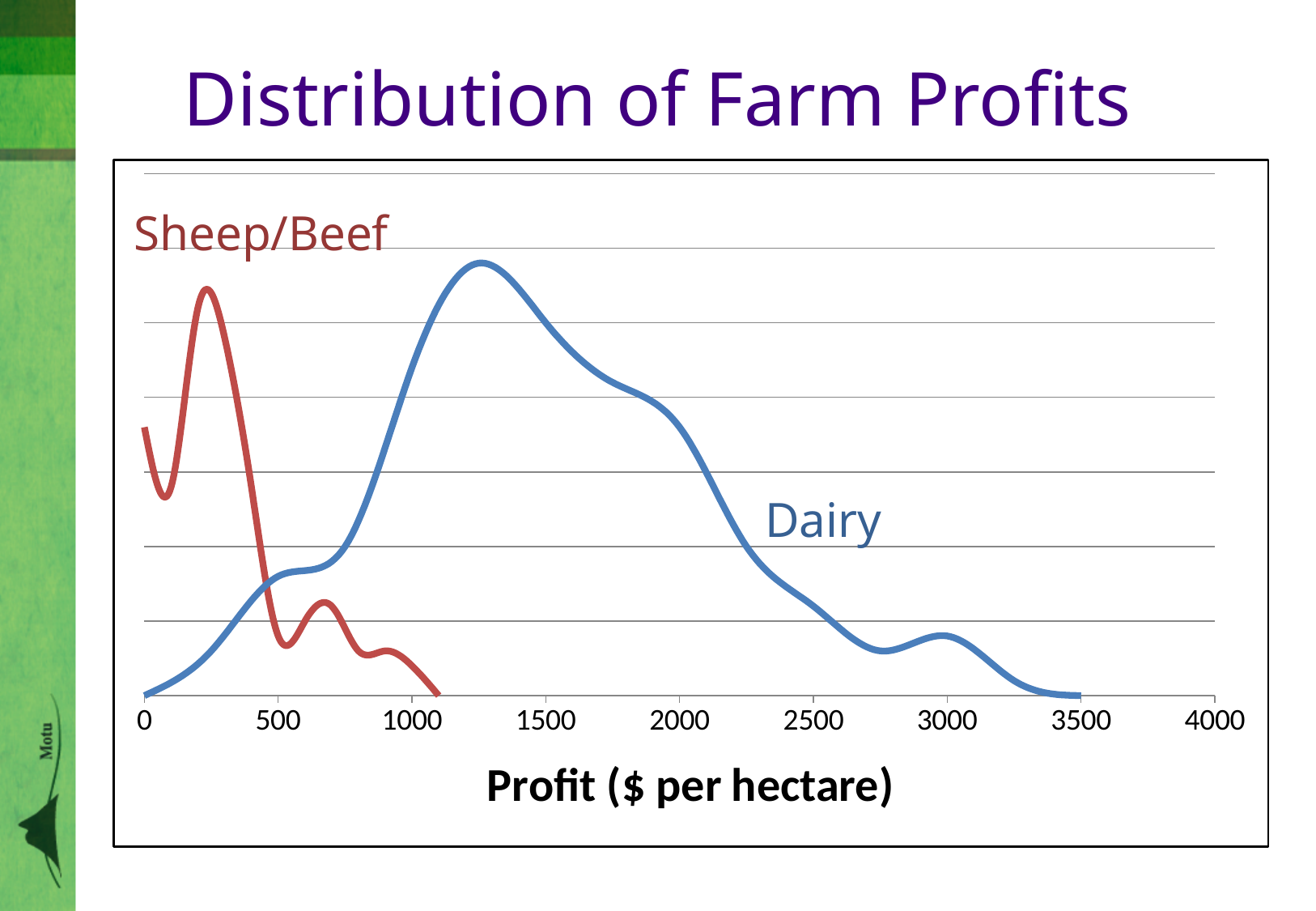
Does the Dairy curve rise or fall between 2000 and 2500 on the x axis? fall What is the highest value shown on the x axis? 4000 How many series are plotted on the chart? 2 What is the label of the x axis? Profit ($ per hectare) What kind of chart is shown on the slide? line chart Which series reaches its peak at a higher profit per hectare, Sheep/Beef or Dairy? Dairy Is the profit at which the Dairy curve peaks greater or less than 1000? greater Which series has the higher peak on the chart? Dairy Is the profit at which the Sheep/Beef curve peaks greater or less than 500? less Is the profit at which the Sheep/Beef curve ends greater or less than 1500? less What is the title of the chart on the slide? Distribution of Farm Profits